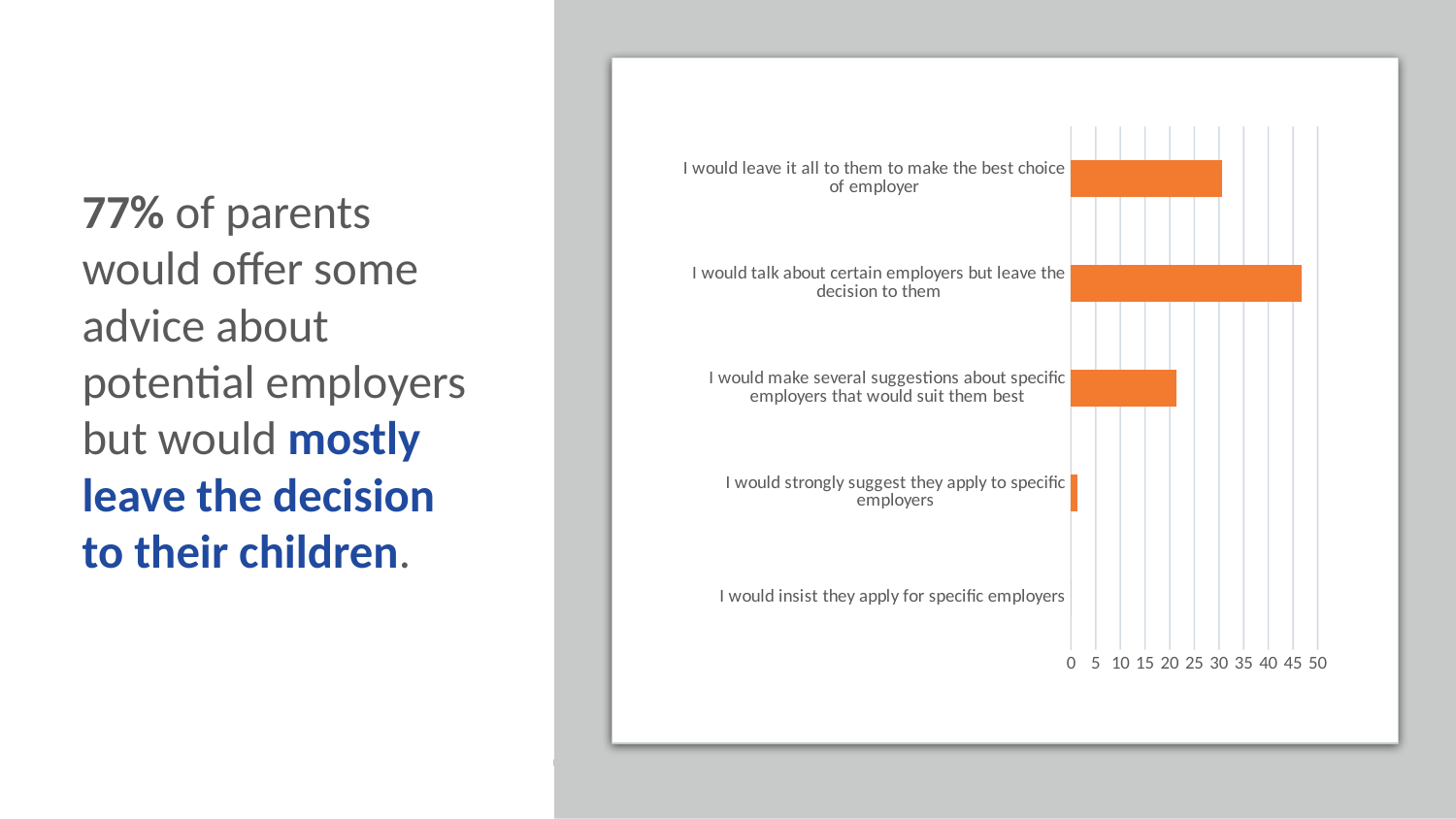
Which is larger: the value for "I would talk about certain employers but leave the decision to them" or the value for "I would leave it all to them to make the best choice of employer"? I would talk about certain employers but leave the decision to them Is the value for "I would make several suggestions about specific employers that would suit them best" greater or less than 15? greater Is the value for "I would leave it all to them to make the best choice of employer" greater or less than 25? greater Is the value for "I would leave it all to them to make the best choice of employer" greater or less than 35? less Which category has the lowest value? I would insist they apply for specific employers Which category has the highest value? I would talk about certain employers but leave the decision to them What kind of chart is shown on the slide? bar chart Which is larger: the value for "I would leave it all to them to make the best choice of employer" or the value for "I would make several suggestions about specific employers that would suit them best"? I would leave it all to them to make the best choice of employer What is the highest value shown on the horizontal axis of the chart? 50 How many categories does the chart show? 5